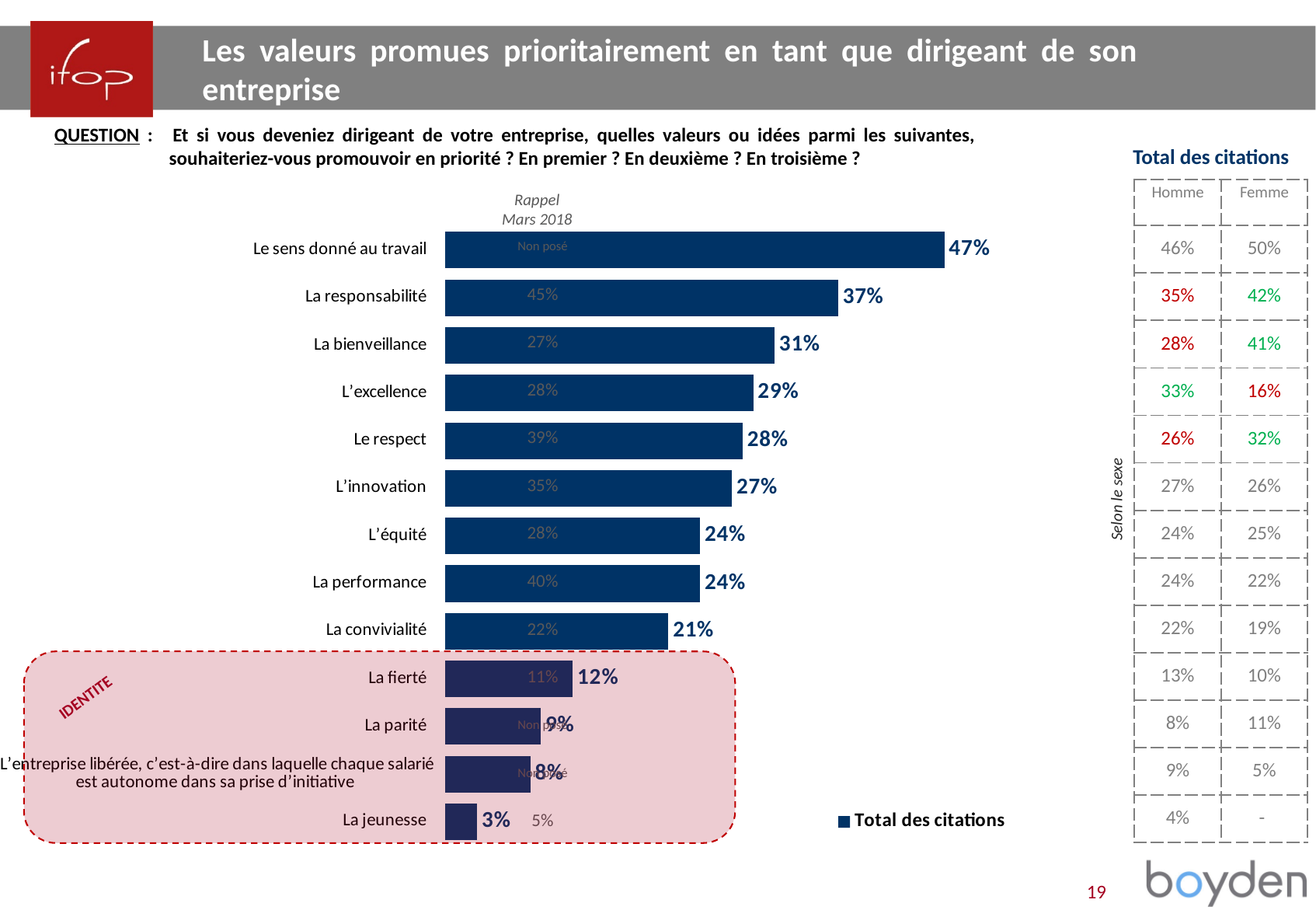
What is the difference between the values for "Le sens donné au travail" and "La responsabilité"? 10% What is the difference between the values for "L'excellence" and "La jeunesse"? 26% How many categories are shown in the bar chart? 13 Which category has the lowest value? La jeunesse What is the value for "Le sens donné au travail"? 47% Which is larger, the value for "Le respect" or the value for "La performance"? Le respect What is the value for "La fierté"? 12% What kind of chart is shown on the slide? Bar chart What is the value for "La bienveillance"? 31% What is the value for "La convivialité"? 21% Which category has the highest value? Le sens donné au travail How many series does the legend list? 1